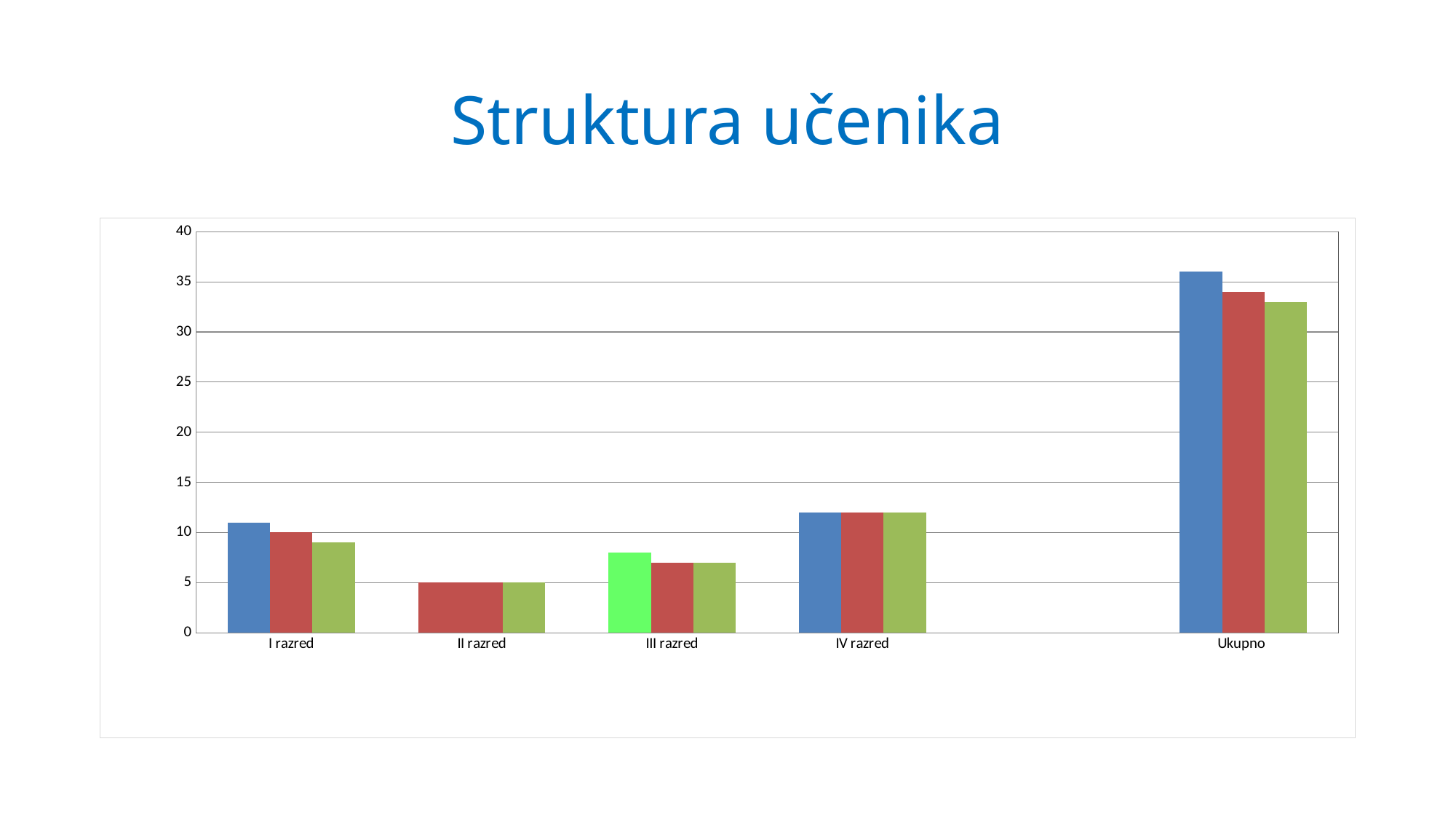
Which category has the tallest bars in the chart? Ukupno How many categories are shown on the x axis of the chart? 5 Which category has the shortest bars in the chart? II razred What kind of chart is shown on the slide? bar chart Is the value of the green bar for Ukupno greater or less than 30? greater Is the value of the blue bar for I razred greater or less than 10? greater Is the value of the green bar for I razred greater or less than 10? less Which is larger: the blue bar for I razred or the blue bar for IV razred? IV razred Which is larger: the blue bar for Ukupno or the green bar for Ukupno? blue bar What is the title of the slide containing the chart? Struktura učenika